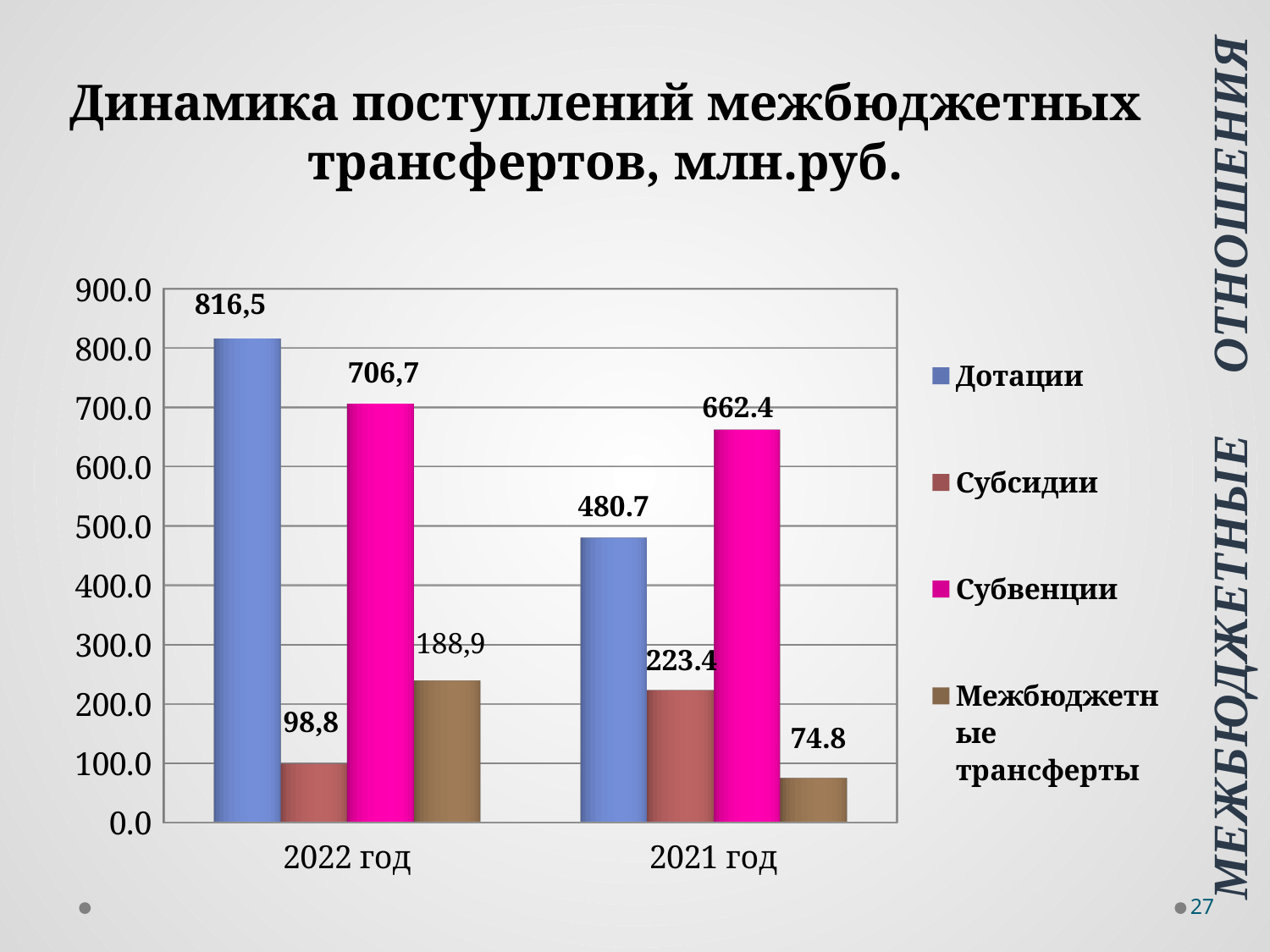
What is the difference between Субвенции and Дотации in 2021 год? 181.7 How many series does the legend list? 4 How many year categories are shown on the x axis? 2 What is the value for Субвенции in 2021 год? 662.4 What is the difference between Дотации and Субвенции in 2022 год? 109,8 Which series has the highest value in 2021 год? Субвенции Which series has the lowest value in 2022 год? Субсидии Which is larger: Субсидии in 2021 год or Субсидии in 2022 год? Субсидии in 2021 год What is the value for Субсидии in 2022 год? 98,8 What is the value for Межбюджетные трансферты in 2021 год? 74.8 What is the value for Дотации in 2022 год? 816,5 What type of chart is shown on the slide? bar chart